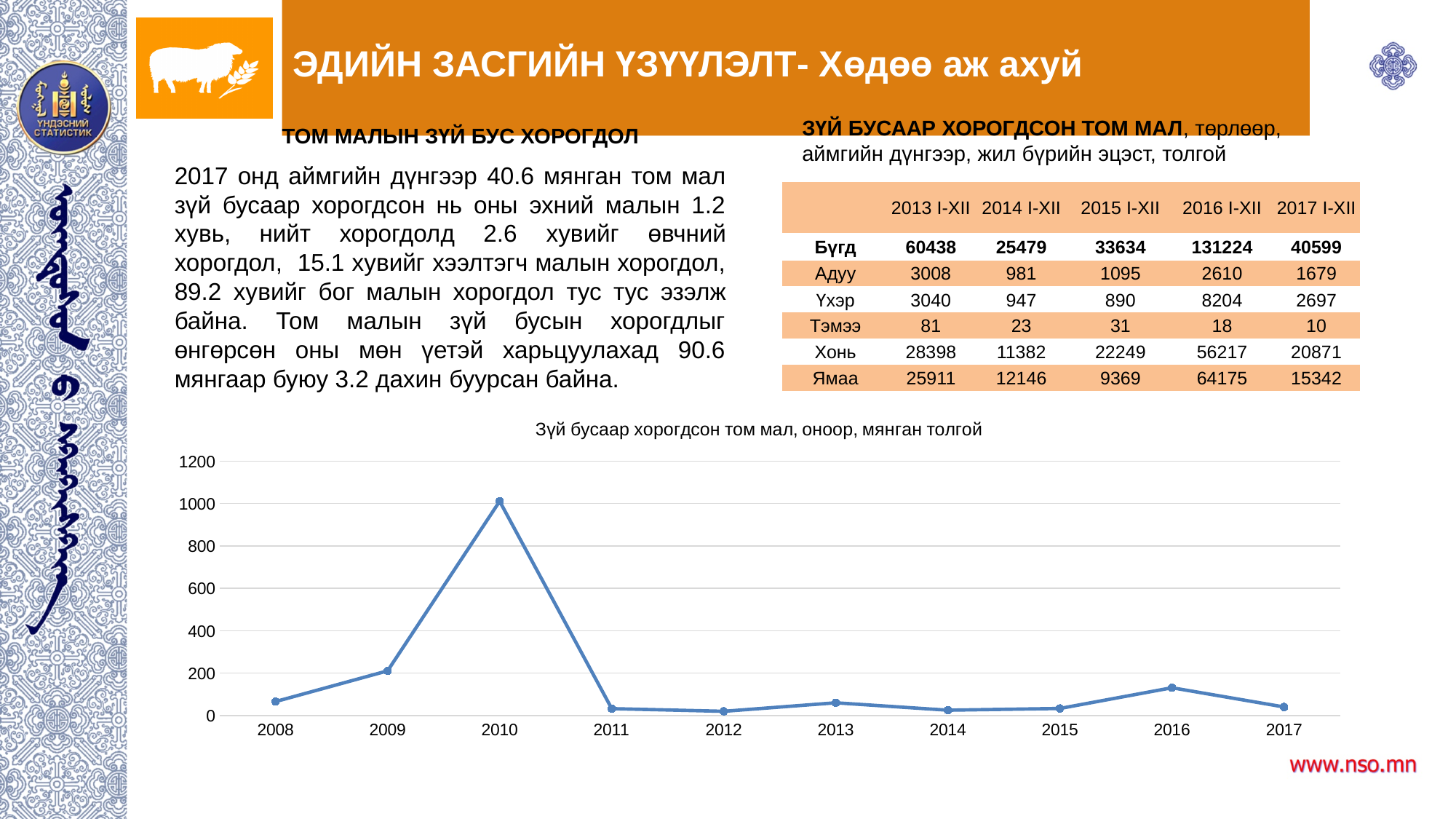
Does the line rise or fall from 2010 to 2011? fall Is the value for 2010 greater or less than 800? greater What kind of chart is shown on the slide? line chart Is the value for 2008 greater or less than 200? less Which year has the highest value in the line chart? 2010 What is the title of the line chart? Зүй бусаар хорогдсон том мал, оноор, мянган толгой Which year has the larger value, 2009 or 2016? 2009 How many years are plotted on the x axis of the line chart? 10 Is the value for 2016 greater or less than 200? less Which year has the larger value, 2010 or 2011? 2010 Does the line rise or fall from 2008 to 2010? rise